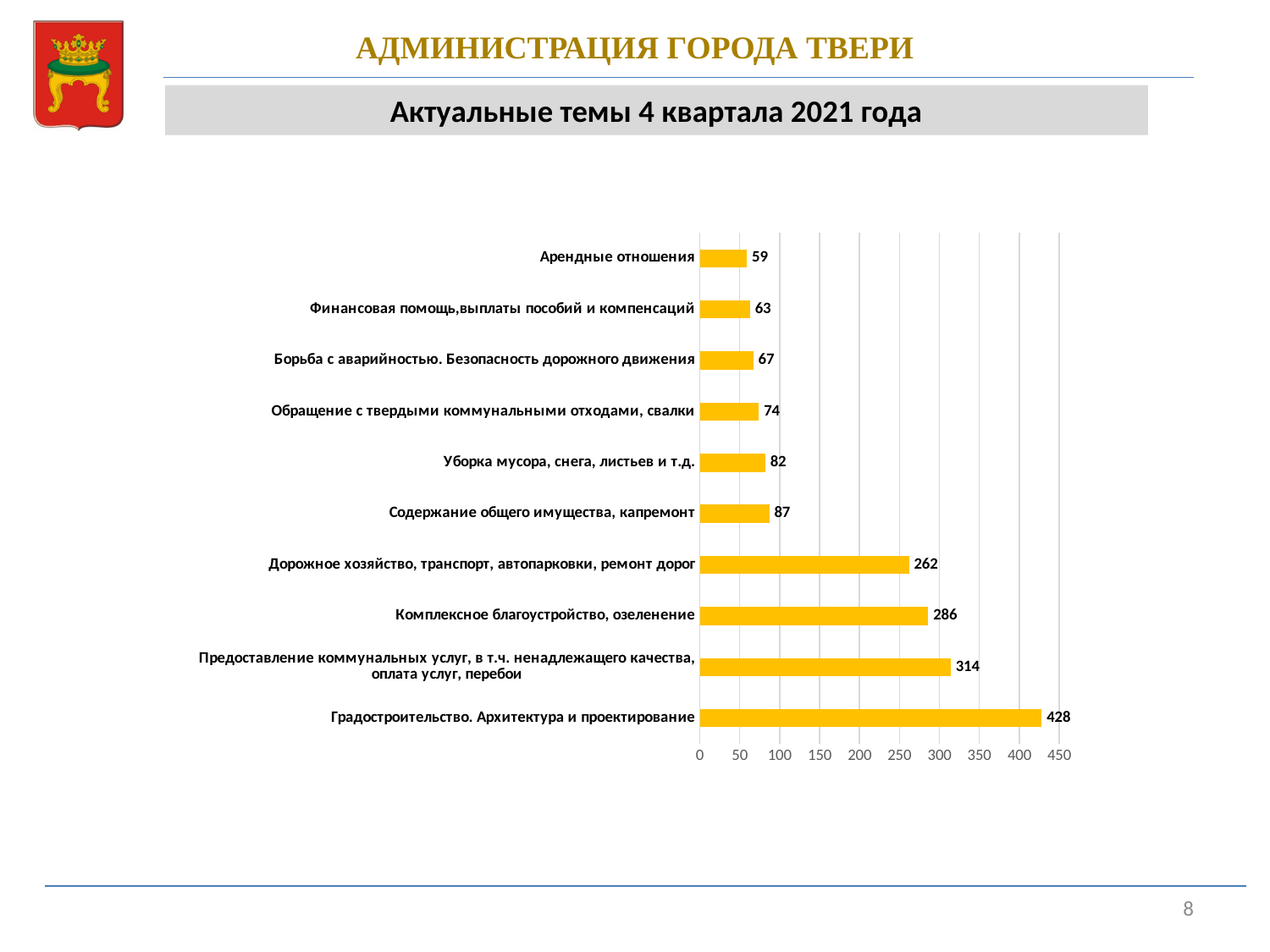
What is the difference between the values for Содержание общего имущества, капремонт and Арендные отношения? 28 Which category has the lowest value? Арендные отношения What kind of chart is shown on the slide? bar chart Which category has the highest value? Градостроительство. Архитектура и проектирование What is the value for Градостроительство. Архитектура и проектирование? 428 What is the difference between the values for Градостроительство. Архитектура и проектирование and Предоставление коммунальных услуг, в т.ч. ненадлежащего качества, оплата услуг, перебои? 114 What is the title of the slide's chart section? Актуальные темы 4 квартала 2021 года How many categories are shown in the chart? 10 Is the value for Обращение с твердыми коммунальными отходами, свалки greater or less than 100? less Which is larger: the value for Дорожное хозяйство, транспорт, автопарковки, ремонт дорог or the value for Комплексное благоустройство, озеленение? Комплексное благоустройство, озеленение What is the value for Комплексное благоустройство, озеленение? 286 What is the value for Уборка мусора, снега, листьев и т.д.? 82